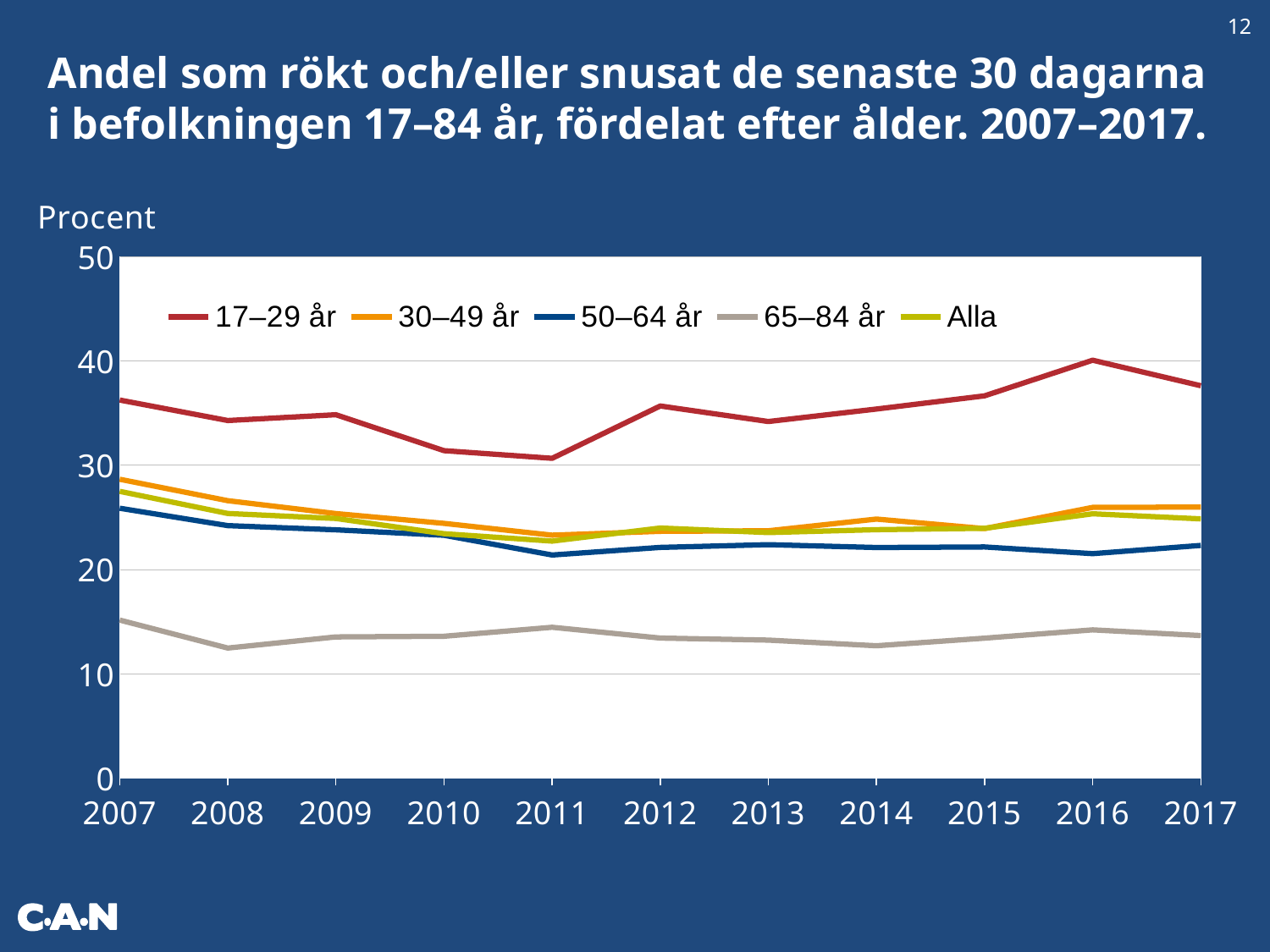
In which year does the 17–29 år series reach its highest value? 2016 What label is shown on the y axis of the chart? Procent In 2007, which is higher: 30–49 år or 50–64 år? 30–49 år How many years are plotted along the x axis? 11 How many series does the legend list? 5 Is the value for 50–64 år in 2011 greater or less than 20? greater What kind of chart is shown on the slide? line chart Is the value for 17–29 år in 2016 greater or less than 30? greater Which age group has the highest value in 2017? 17–29 år Which age group has the lowest value in 2017? 65–84 år Does the 50–64 år series rise or fall from 2007 to 2011? fall Is the value for 65–84 år in 2008 greater or less than 15? less